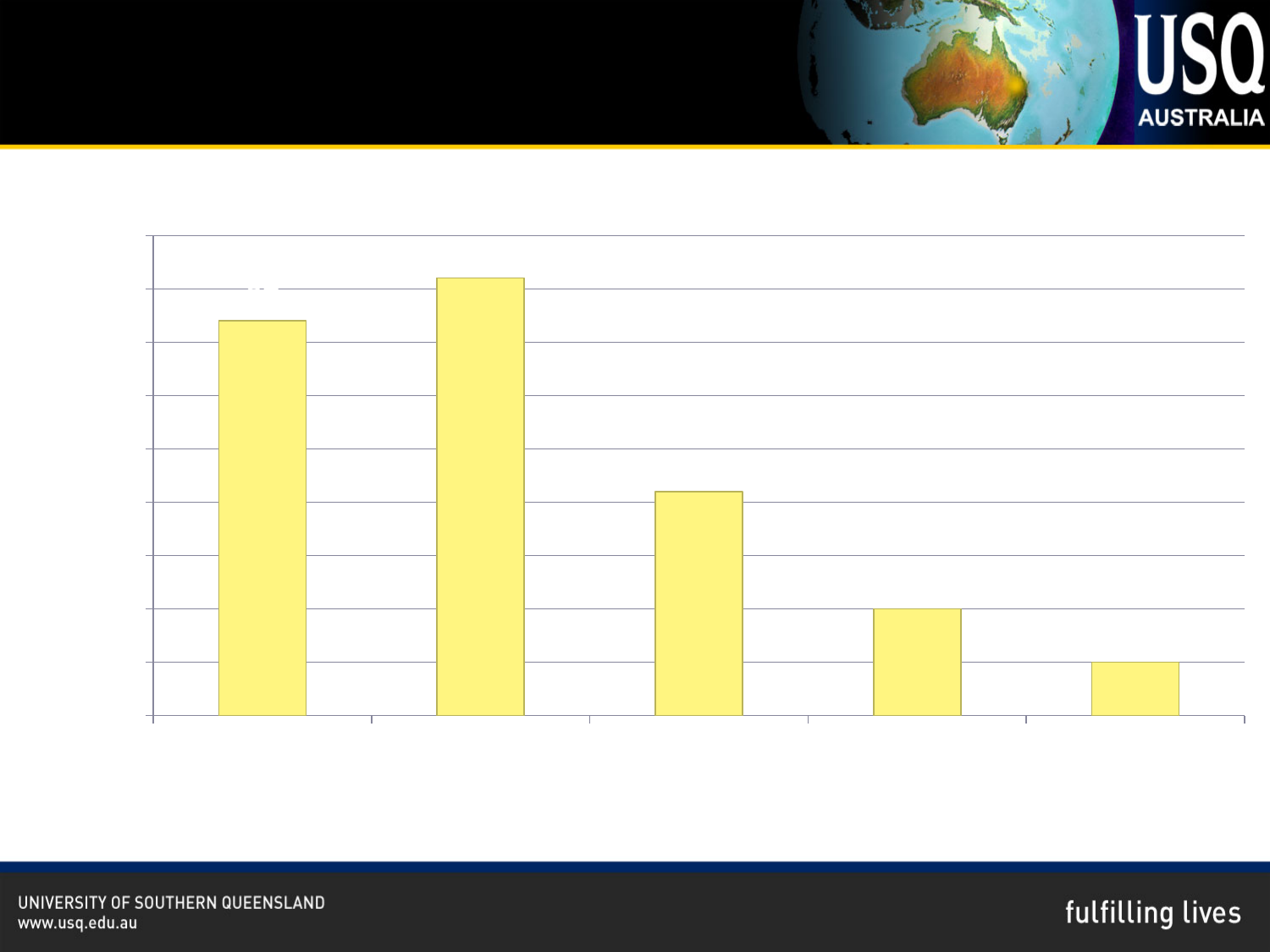
Do the bar heights rise or fall from the second bar to the fifth bar? fall How many bars are plotted in the chart? 5 What kind of chart is shown on the slide? bar chart Which is taller, the fourth bar from the left or the fifth bar from the left? the fourth bar Which bar, counting from the left, is the tallest in the chart? the second bar What colour are the bars in the chart? yellow Which is taller, the first bar from the left or the third bar from the left? the first bar Which bar, counting from the left, is the shortest in the chart? the fifth bar Which is taller, the second bar from the left or the first bar from the left? the second bar Are the bars in the chart vertical or horizontal? vertical